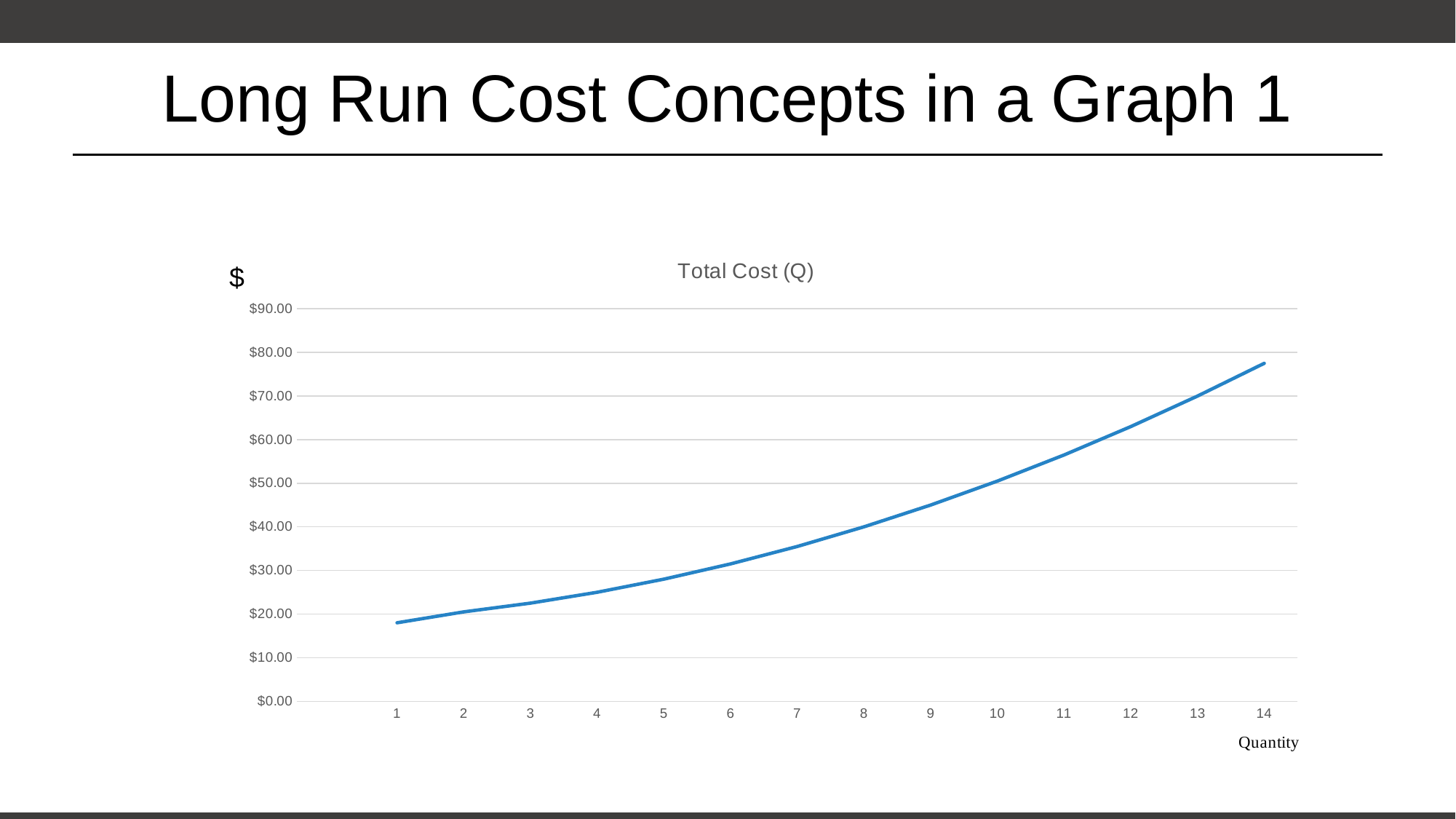
Is the total cost at quantity 8 greater or less than $50.00? less Is the total cost at quantity 1 greater or less than $20.00? less How many quantity points are plotted on the x axis? 14 At which quantity is total cost highest? 14 Is the total cost at quantity 11 greater or less than $50.00? greater Does total cost rise or fall as quantity increases from 1 to 14? rise What label is shown on the x axis of the chart? Quantity Which has the larger total cost, quantity 5 or quantity 12? quantity 12 What is the title of the chart? Total Cost (Q) At which quantity is total cost lowest? 1 What kind of chart is shown on the slide? line chart